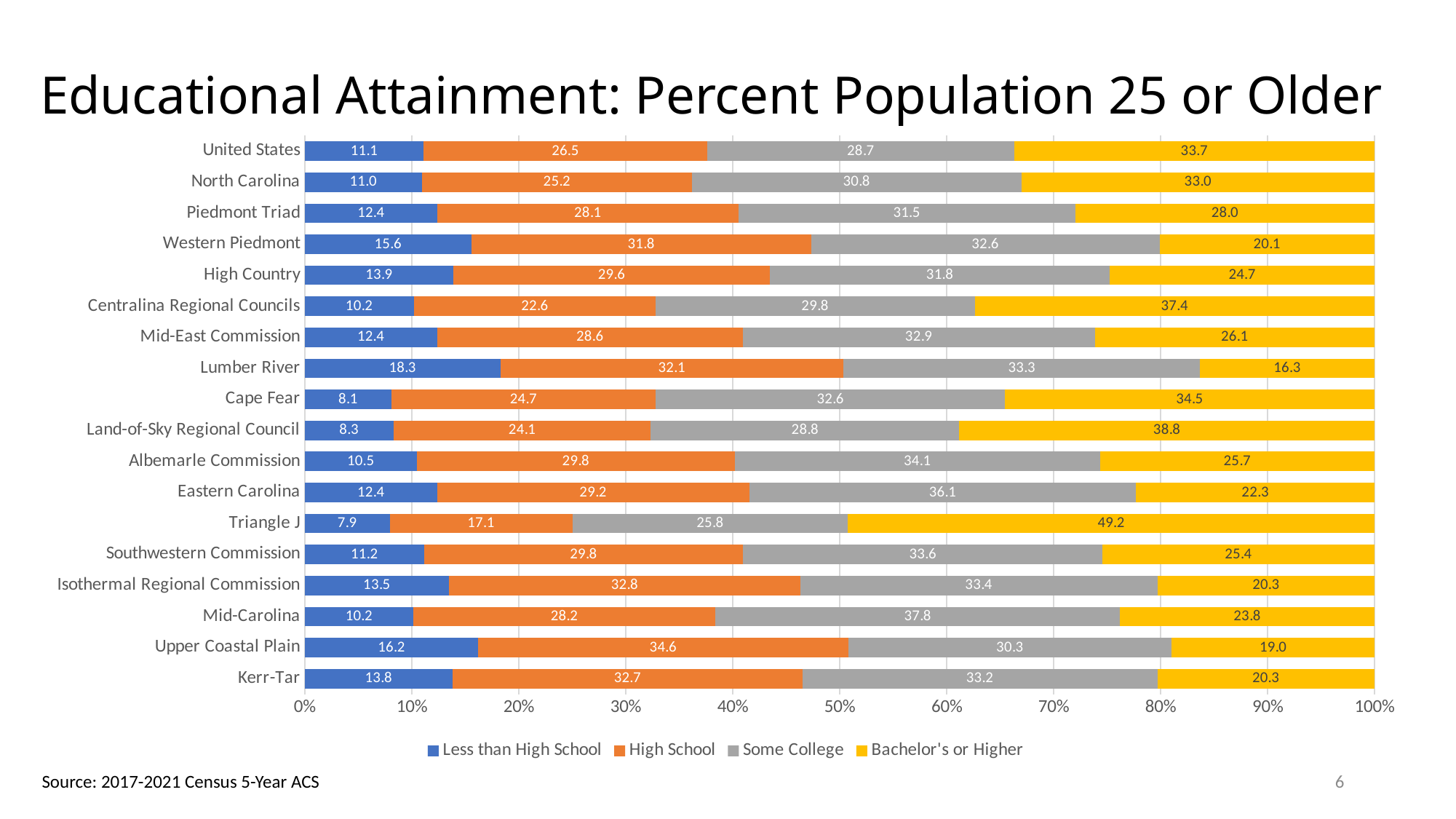
Which region has the lowest Bachelor's or Higher value? Lumber River What kind of chart is shown on the slide? Stacked bar chart What is the Some College value for Mid-Carolina? 37.8 Which region has the lowest Less than High School value? Triangle J What is the Less than High School value for Lumber River? 18.3 Which colour represents the Some College series? Gray What is the Bachelor's or Higher value for Triangle J? 49.2 Which region has the highest Bachelor's or Higher value? Triangle J What is the difference between the Bachelor's or Higher values for Triangle J and Lumber River? 32.9 How many regions (categories) are shown on the chart? 18 Which has a larger High School value, Upper Coastal Plain or Kerr-Tar? Upper Coastal Plain How many series does the legend list? 4